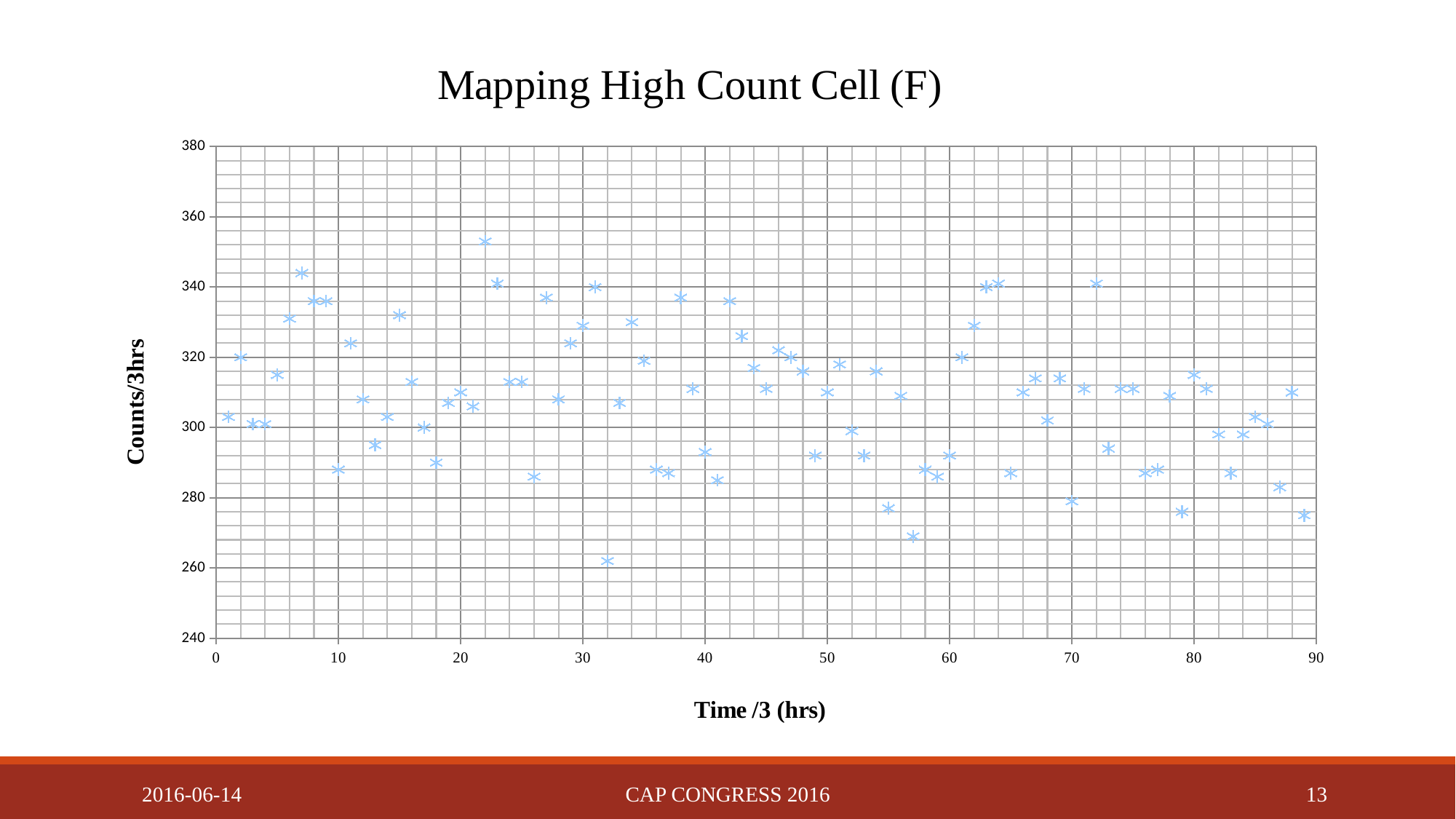
Is the value at x = 22 greater or less than 340? greater At which x value (Time /3 (hrs)) does the highest point occur? 22 What kind of chart is shown on the slide? Scatter plot What is the label on the vertical axis of the chart? Counts/3hrs Is the value at x = 57 greater or less than 280? less Which point has the larger value, the one at x = 7 or the one at x = 10? x = 7 What is the title of the chart? Mapping High Count Cell (F) Is the value at x = 32 greater or less than 280? less At which x value (Time /3 (hrs)) does the lowest point occur? 32 Which point has the larger value, the one at x = 22 or the one at x = 32? x = 22